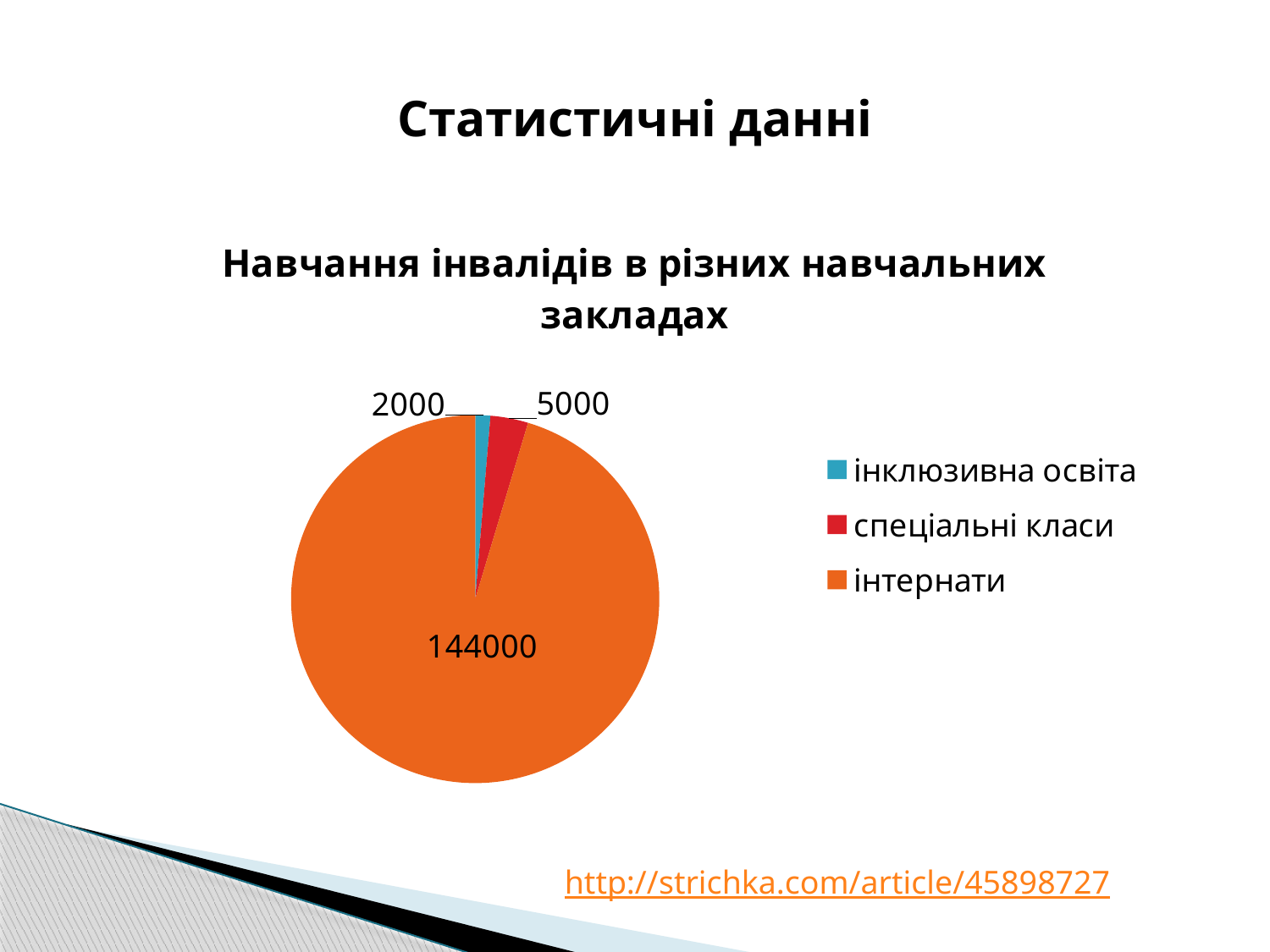
What is the value for спеціальні класи? 5000 What is the value for інтернати? 144000 Which category has the smallest slice? інклюзивна освіта What is the title of the chart? Навчання інвалідів в різних навчальних закладах What is the value for інклюзивна освіта? 2000 What type of chart is shown on the slide? pie chart Which is larger, the value for спеціальні класи or the value for інклюзивна освіта? спеціальні класи What colour is the slice for інтернати? orange What is the difference between the values for спеціальні класи and інклюзивна освіта? 3000 How many slices does the pie chart have? 3 Which category has the largest slice? інтернати How many entries does the legend list? 3